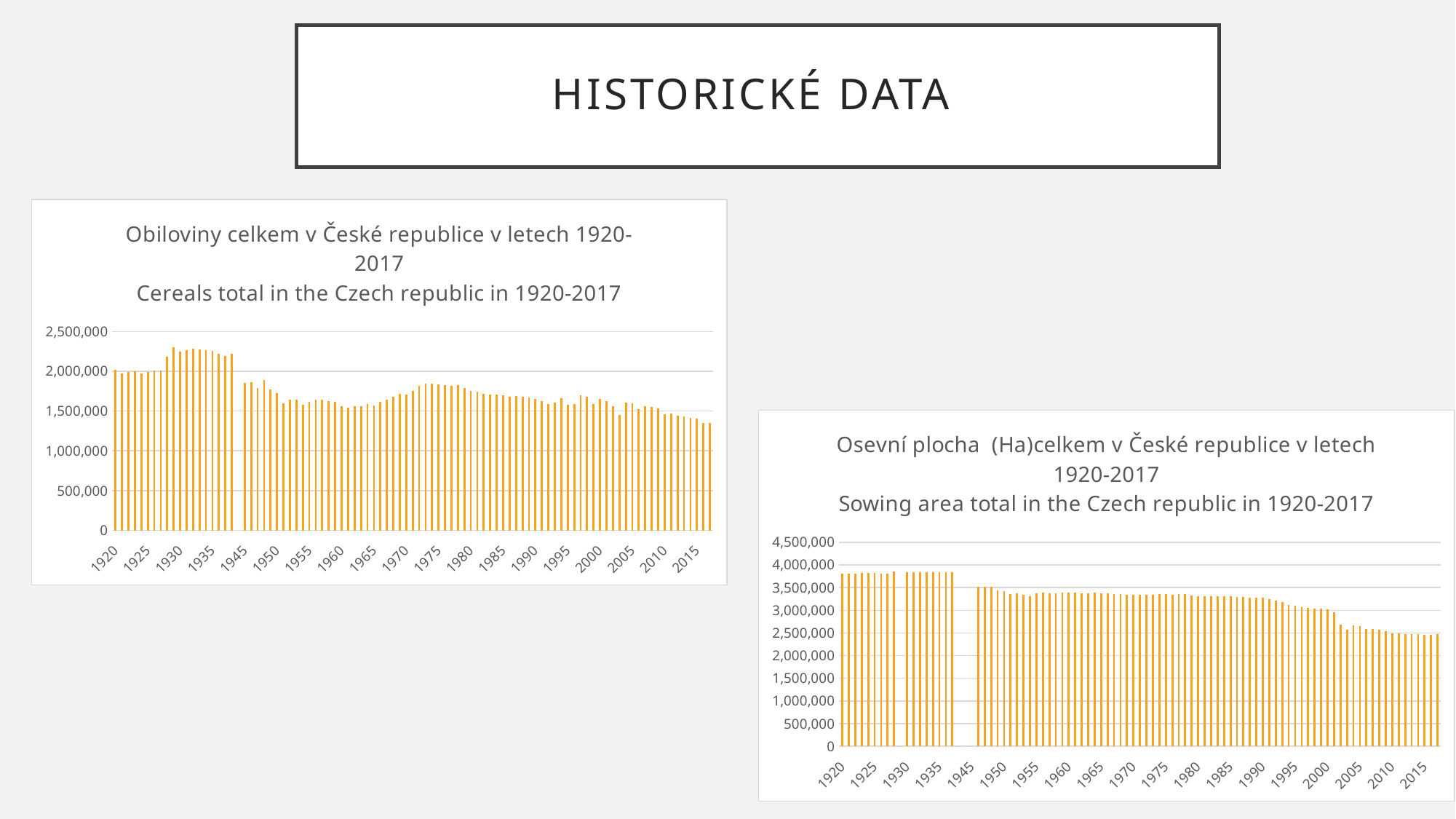
What kind of chart is the 'Sowing area total in the Czech republic in 1920-2017' chart? bar chart In the 'Cereals total in the Czech republic in 1920-2017' chart, which is larger, the value for 1930 or the value for 2015? 1930 In the 'Cereals total in the Czech republic in 1920-2017' chart, is the value for 2015 greater or less than 1,500,000? less In the 'Sowing area total in the Czech republic in 1920-2017' chart, is the value for 1920 greater or less than 3,500,000? greater In the 'Cereals total in the Czech republic in 1920-2017' chart, do the values overall rise or fall from 1920 to 2017? fall In the 'Cereals total in the Czech republic in 1920-2017' chart, is the value for 1975 greater or less than 2,000,000? less In the 'Sowing area total in the Czech republic in 1920-2017' chart, which is larger, the value for 1920 or the value for 2010? 1920 What is the highest value shown on the vertical axis of the 'Sowing area total in the Czech republic in 1920-2017' chart? 4,500,000 What kind of chart is the 'Cereals total in the Czech republic in 1920-2017' chart? bar chart In the 'Sowing area total in the Czech republic in 1920-2017' chart, do the values overall rise or fall from 1920 to 2017? fall